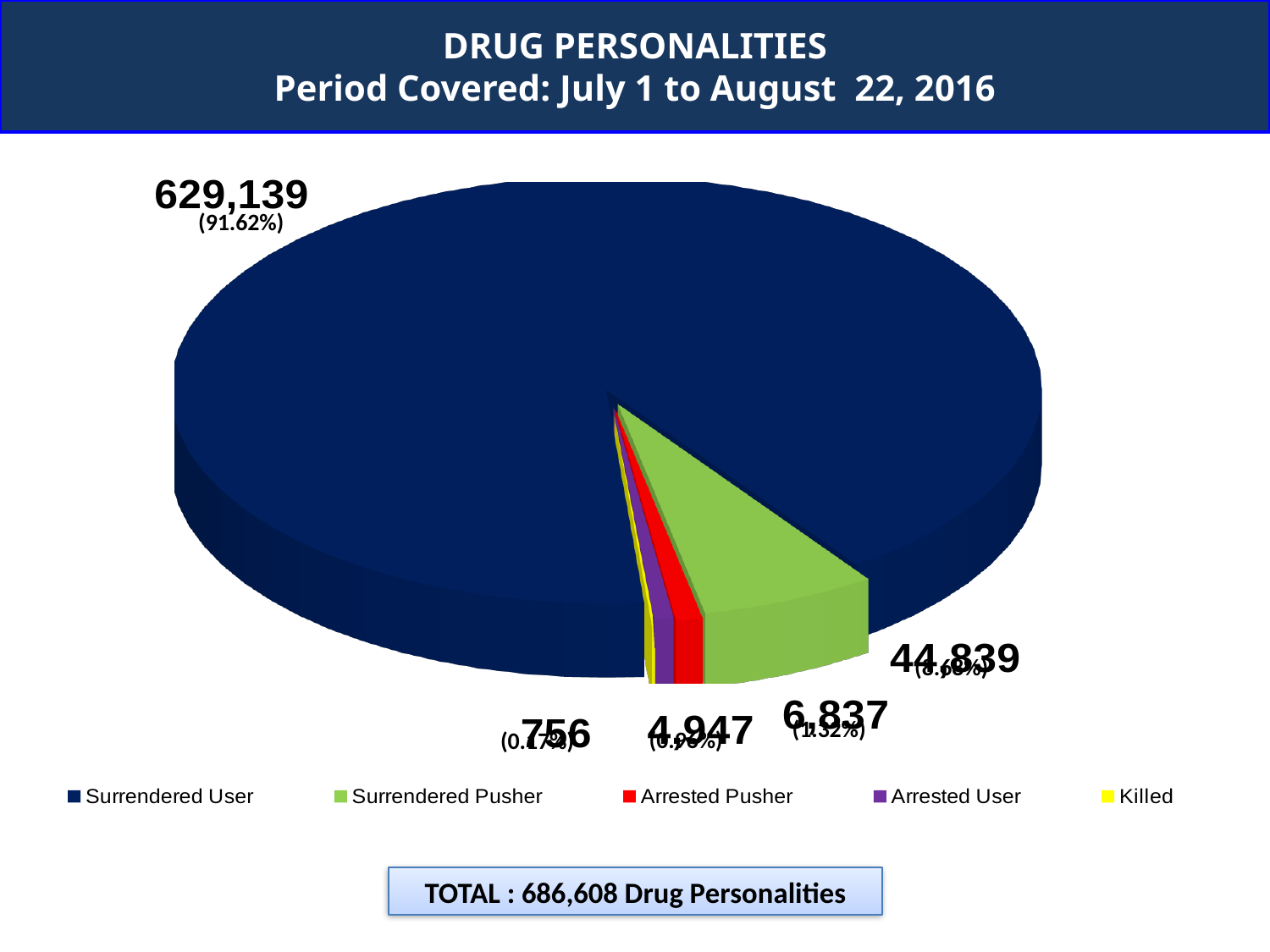
Which category has the largest slice of the pie? Surrendered User What kind of chart is shown on the slide? pie chart Which is larger, the value for Arrested Pusher or the value for Arrested User? Arrested Pusher How many slices does the pie chart have? 5 What is the value for Killed? 756 What share of the pie does Surrendered User represent? 91.62% What is the difference between the Surrendered User value and the Surrendered Pusher value? 584,300 Which category has the smallest slice of the pie? Killed What is the value for Surrendered User? 629,139 What total number of drug personalities is stated on the slide? 686,608 How many entries does the legend list? 5 What is the value for Surrendered Pusher? 44,839